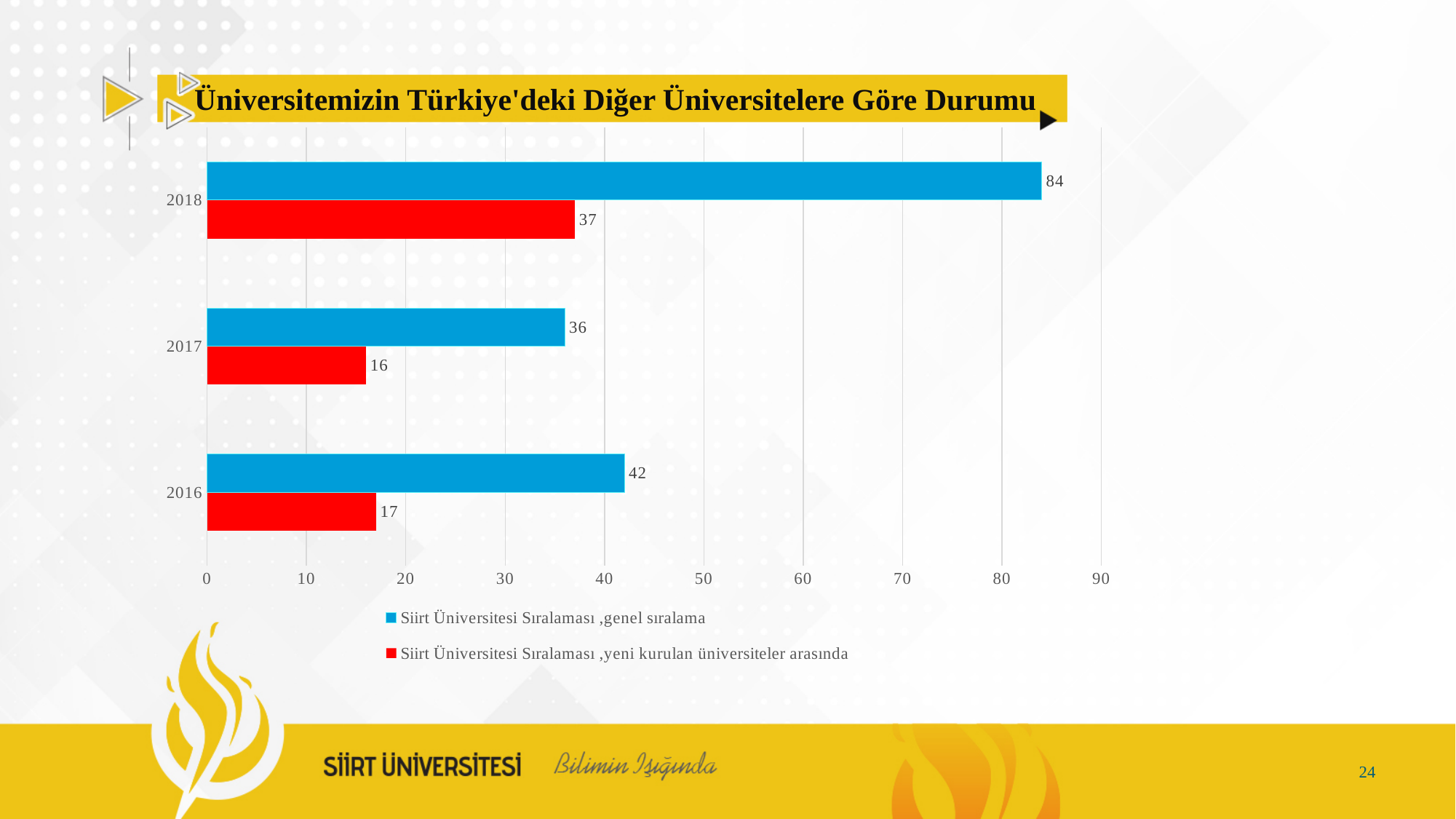
Is the 'genel sıralama' value for 2018 greater or less than 80? greater What is the difference between the 'genel sıralama' value and the 'yeni kurulan üniversiteler arasında' value for 2018? 47 What is the value of 'Siirt Üniversitesi Sıralaması ,genel sıralama' for 2016? 42 Which year has the highest value for 'Siirt Üniversitesi Sıralaması ,genel sıralama'? 2018 What colour represents 'Siirt Üniversitesi Sıralaması ,yeni kurulan üniversiteler arasında' in the chart? red Which is larger: the 'genel sıralama' value for 2016 or for 2017? 2016 What kind of chart is shown on the slide? bar chart What is the value of 'Siirt Üniversitesi Sıralaması ,genel sıralama' for 2018? 84 How many series does the legend list? 2 How many years are shown on the chart? 3 What is the value of 'Siirt Üniversitesi Sıralaması ,yeni kurulan üniversiteler arasında' for 2017? 16 Which year has the lowest value for 'Siirt Üniversitesi Sıralaması ,yeni kurulan üniversiteler arasında'? 2017